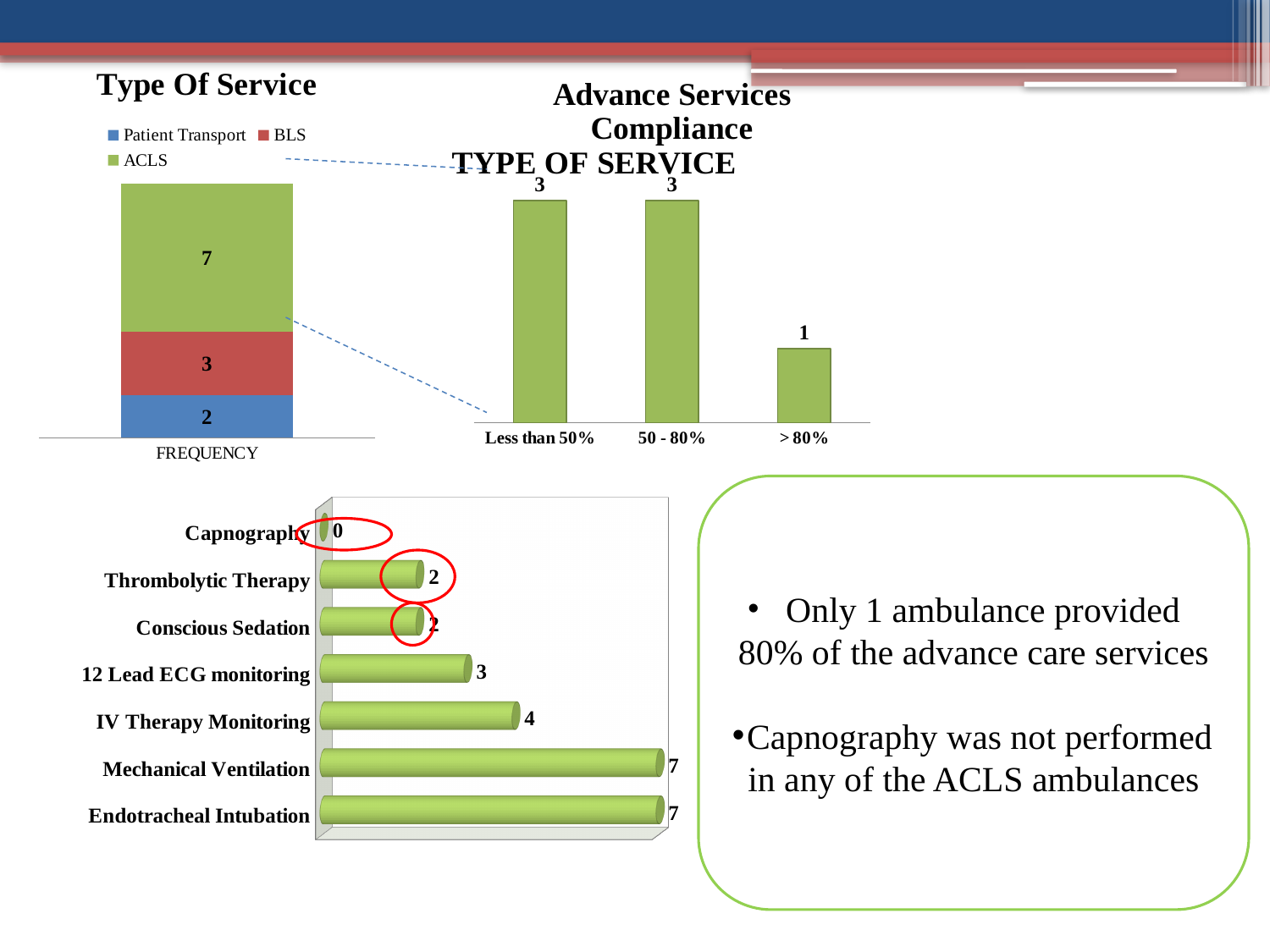
In the 'Type Of Service' chart, what is the value for Patient Transport? 2 In the bottom-left horizontal bar chart, which category has the lowest value? Capnography How many series does the legend of the 'Type Of Service' chart list? 3 In the bottom-left horizontal bar chart, what is the value for IV Therapy Monitoring? 4 In the 'Type Of Service' chart, what is the total of the stacked bar? 12 How many categories are shown in the bottom-left horizontal bar chart? 7 In the 'Advance Services Compliance' chart, what is the value for '> 80%'? 1 In the bottom-left horizontal bar chart, what is the difference between Mechanical Ventilation and 12 Lead ECG monitoring? 4 In the 'Advance Services Compliance' chart, what is the value for 'Less than 50%'? 3 How many categories are shown in the 'Advance Services Compliance' chart? 3 In the 'Type Of Service' chart, what is the value for ACLS? 7 In the 'Type Of Service' chart, which series has the largest value? ACLS